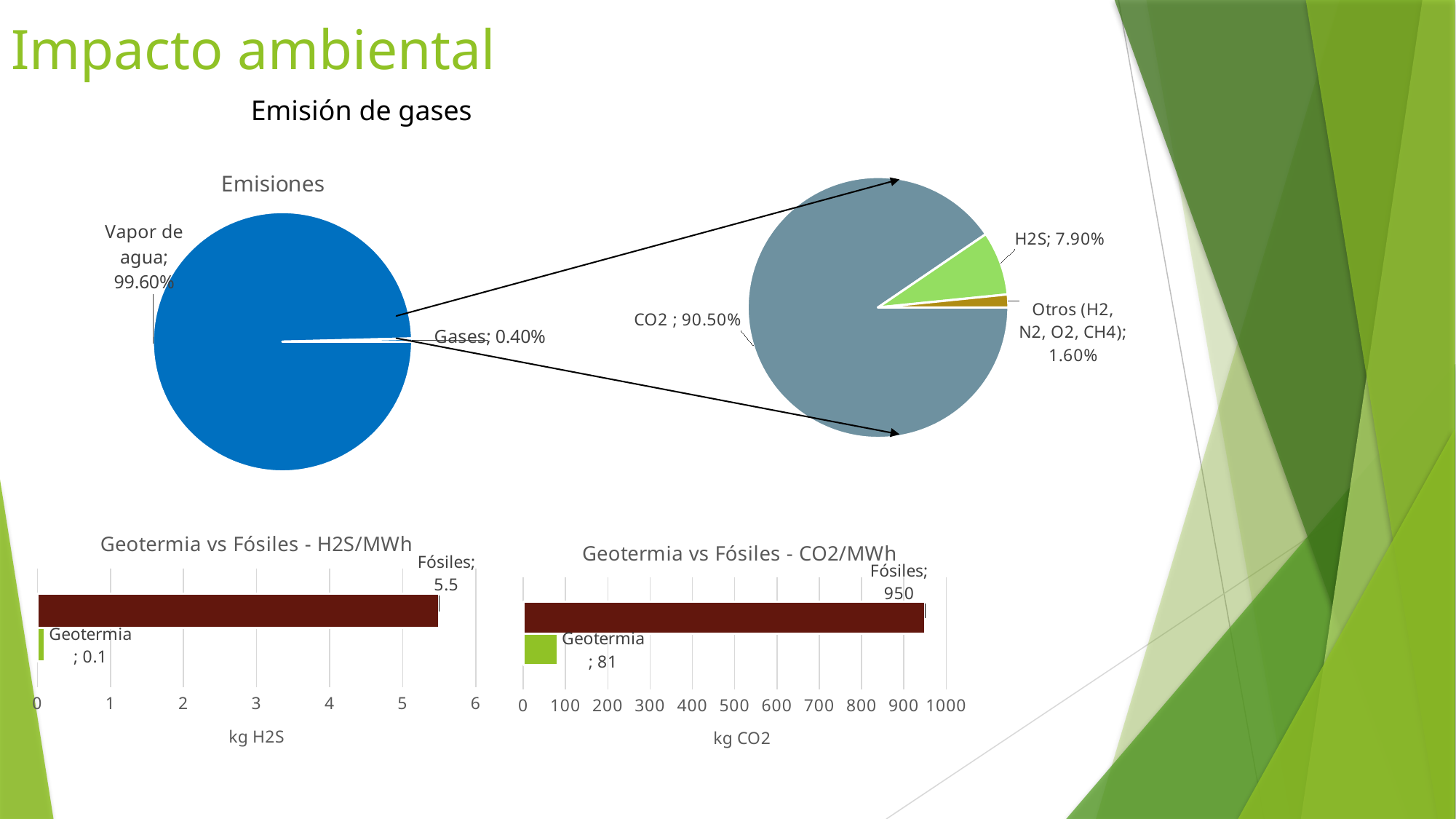
In the gas breakdown pie chart on the right, which slice is the smallest? Otros (H2, N2, O2, CH4) In the 'Geotermia vs Fósiles - CO2/MWh' chart, what is the value for Fósiles? 950 In the 'Emisiones' pie chart, what share is labelled for Vapor de agua? 99.60% In the 'Emisiones' pie chart, what share is labelled for Gases? 0.40% What kind of chart is 'Geotermia vs Fósiles - CO2/MWh'? Bar chart In the gas breakdown pie chart on the right, what share is labelled for CO2? 90.50% In the 'Geotermia vs Fósiles - H2S/MWh' chart, what is the value for Fósiles? 5.5 In the 'Geotermia vs Fósiles - CO2/MWh' chart, what is the difference between the Fósiles and Geotermia values? 869 In the gas breakdown pie chart on the right, what share is labelled for H2S? 7.90% What is the x-axis label of the 'Geotermia vs Fósiles - H2S/MWh' chart? kg H2S In the 'Geotermia vs Fósiles - H2S/MWh' chart, what is the value for Geotermia? 0.1 In the gas breakdown pie chart on the right, how many slices are there? 3